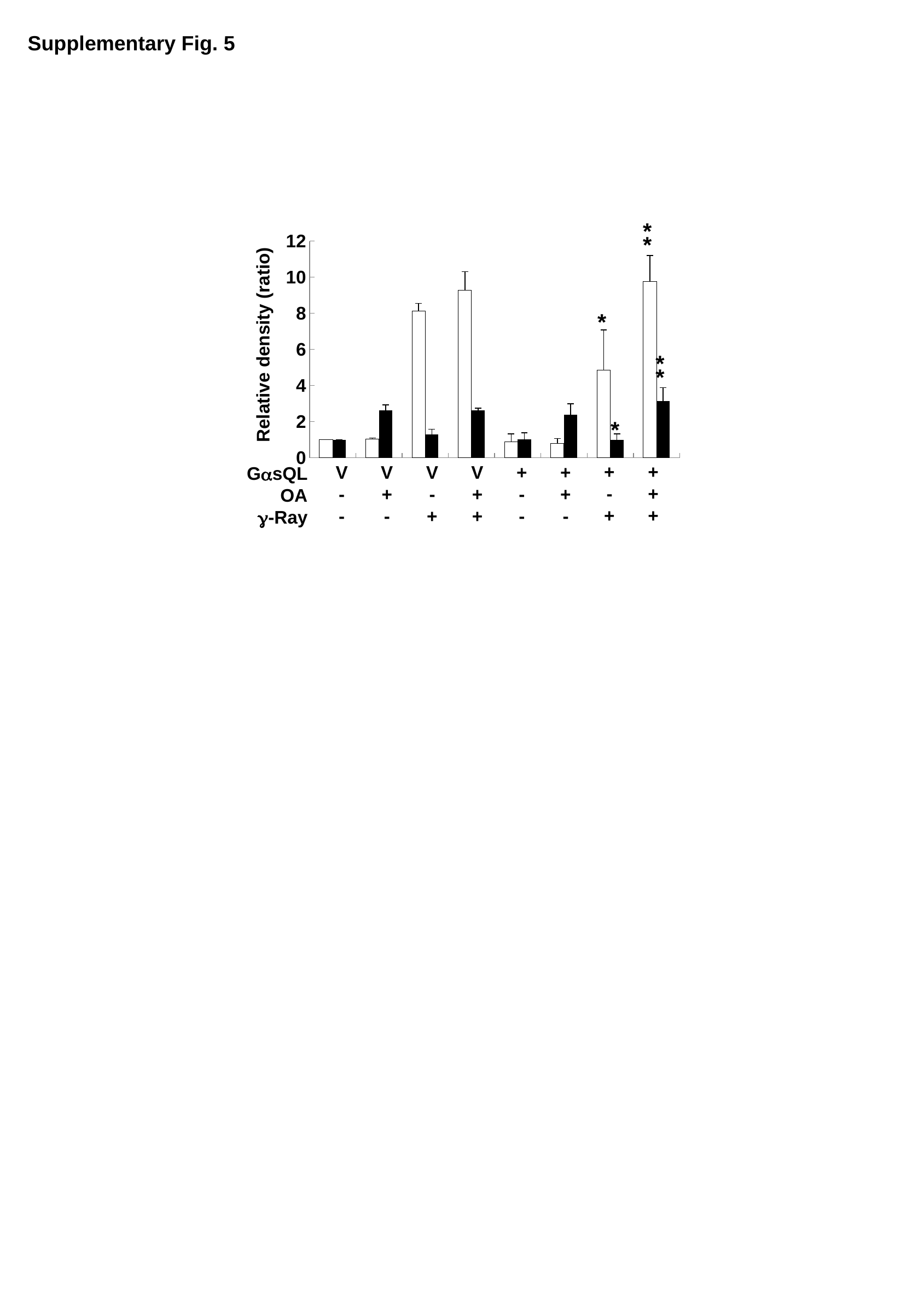
What kind of chart is shown on the slide? bar chart For the condition GαsQL V, OA +, γ-Ray -, which bar is taller, the white bar or the black bar? the black bar Is the white bar for the condition GαsQL V, OA +, γ-Ray + greater or less than 8? greater Is the white bar for the condition GαsQL +, OA +, γ-Ray - greater or less than 2? less Is the white bar for the condition GαsQL +, OA -, γ-Ray + greater or less than 6? less What is the label of the y axis? Relative density (ratio) For the condition GαsQL V, OA -, γ-Ray +, which bar is taller, the white bar or the black bar? the white bar Which white bar is taller: the one for GαsQL +, OA -, γ-Ray + or the one for GαsQL +, OA +, γ-Ray +? GαsQL +, OA +, γ-Ray + How many groups of bars are plotted along the x axis? 8 How many bars are there in each group along the x axis? 2